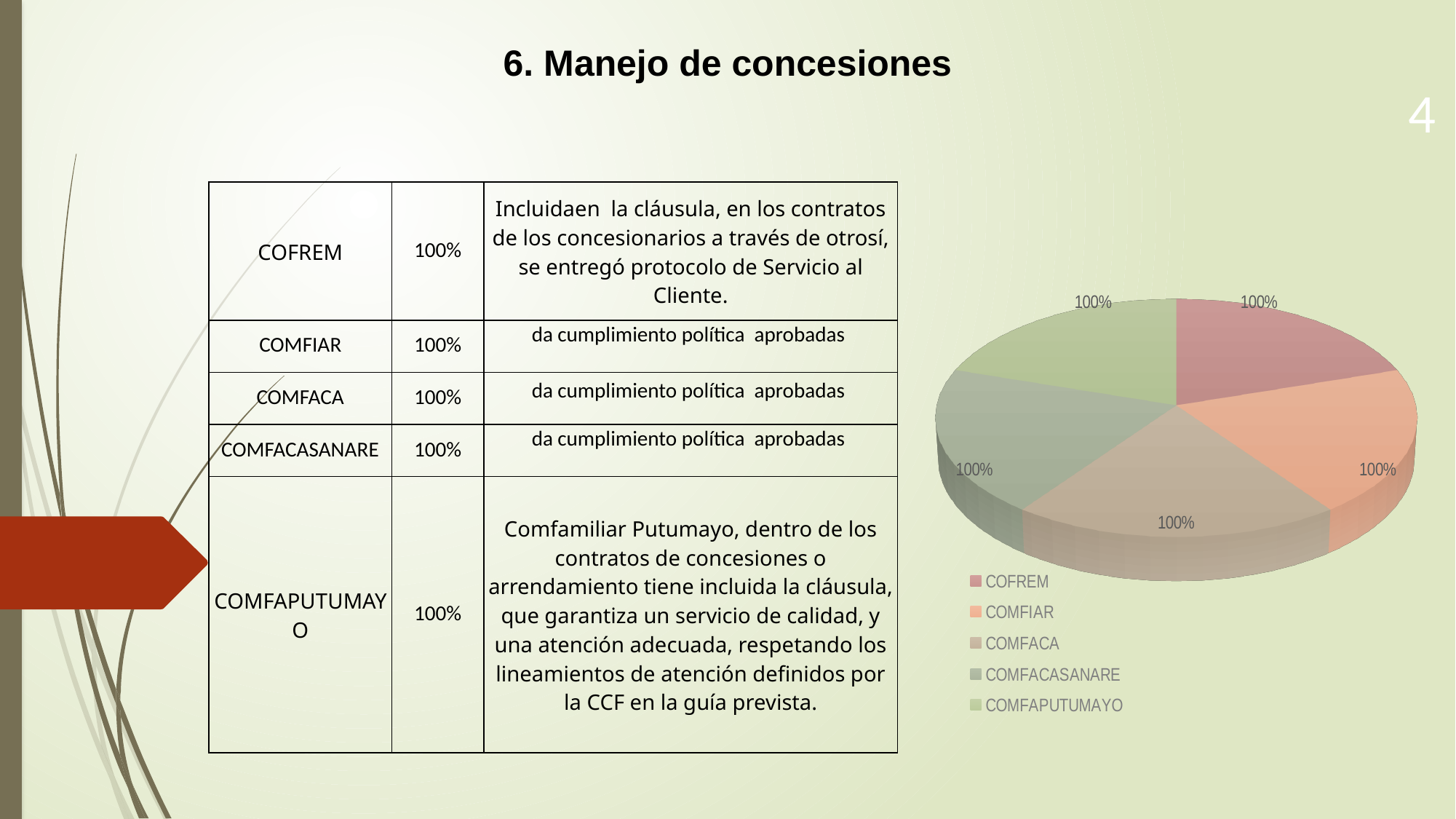
What is the difference between the labelled values for COFREM and COMFAPUTUMAYO in the pie chart? 0% What value is labelled on the COMFACA slice of the pie chart? 100% What value is labelled on the COFREM slice of the pie chart? 100% How many entries does the legend of the pie chart list? 5 How many slices does the pie chart have? 5 What value is labelled on the COMFACASANARE slice of the pie chart? 100% What kind of chart is shown on the slide? pie chart Which legend entry is listed first in the pie chart's legend? COFREM What value is labelled on the COMFAPUTUMAYO slice of the pie chart? 100% What value is labelled on the COMFIAR slice of the pie chart? 100% Which legend entry is listed last in the pie chart's legend? COMFAPUTUMAYO